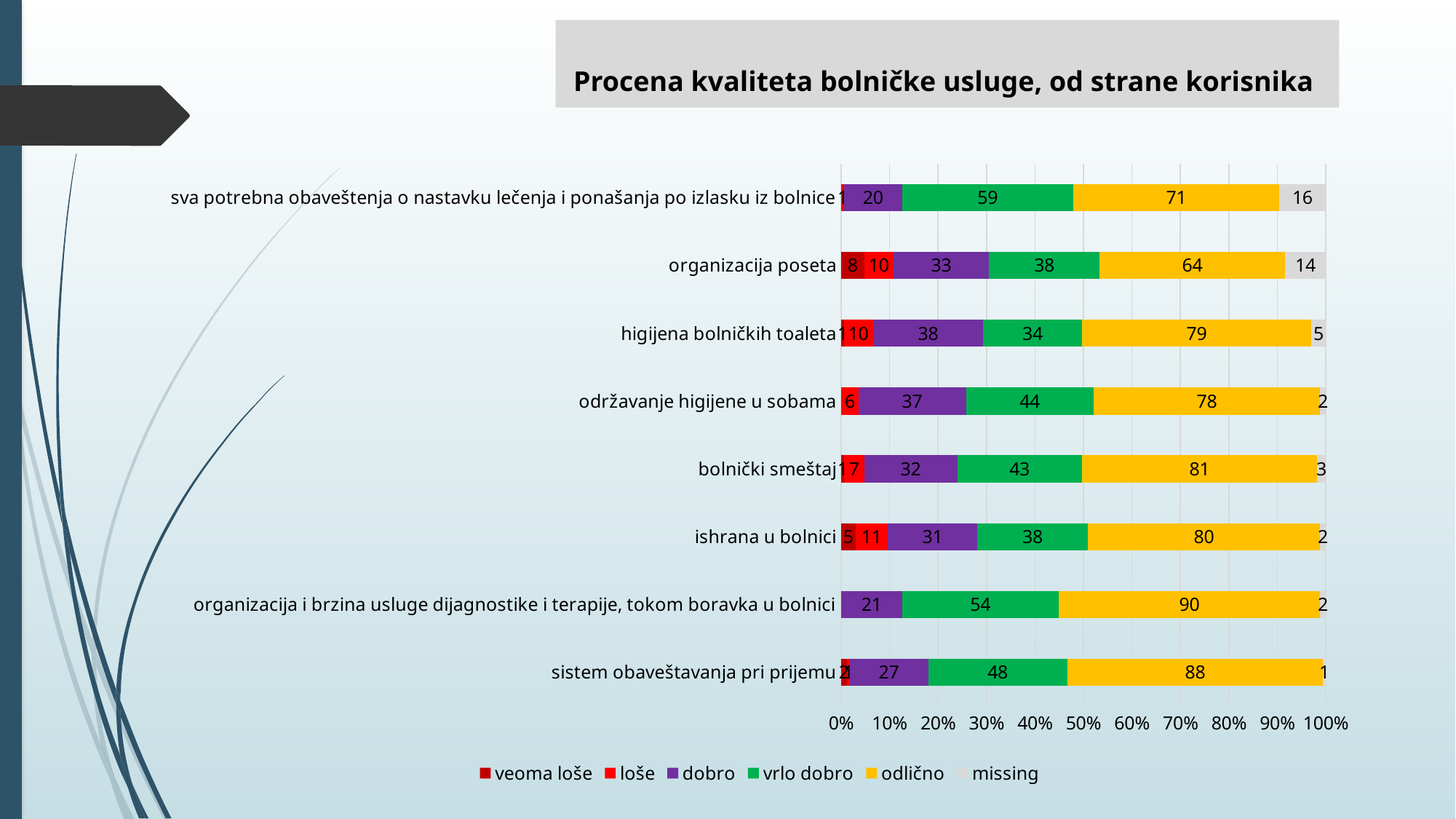
What is the value of the 'odlično' segment for 'organizacija i brzina usluge dijagnostike i terapije, tokom boravka u bolnici'? 90 Which category has the lowest 'odlično' value? organizacija poseta Which has the larger 'vrlo dobro' value: 'sva potrebna obaveštenja o nastavku lečenja i ponašanja po izlasku iz bolnice' or 'organizacija i brzina usluge dijagnostike i terapije, tokom boravka u bolnici'? sva potrebna obaveštenja o nastavku lečenja i ponašanja po izlasku iz bolnice What type of chart is shown on the slide? Stacked bar chart What is the 'dobro' value for 'organizacija poseta'? 33 What is the 'veoma loše' value for 'organizacija poseta'? 8 How many categories are shown on the chart? 8 How many series does the legend list? 6 Which category has the highest 'odlično' value? organizacija i brzina usluge dijagnostike i terapije, tokom boravka u bolnici What is the difference between the 'odlično' values for 'bolnički smeštaj' and 'ishrana u bolnici'? 1 What is the 'vrlo dobro' value for 'sistem obaveštavanja pri prijemu'? 48 What is the 'missing' value for 'sva potrebna obaveštenja o nastavku lečenja i ponašanja po izlasku iz bolnice'? 16